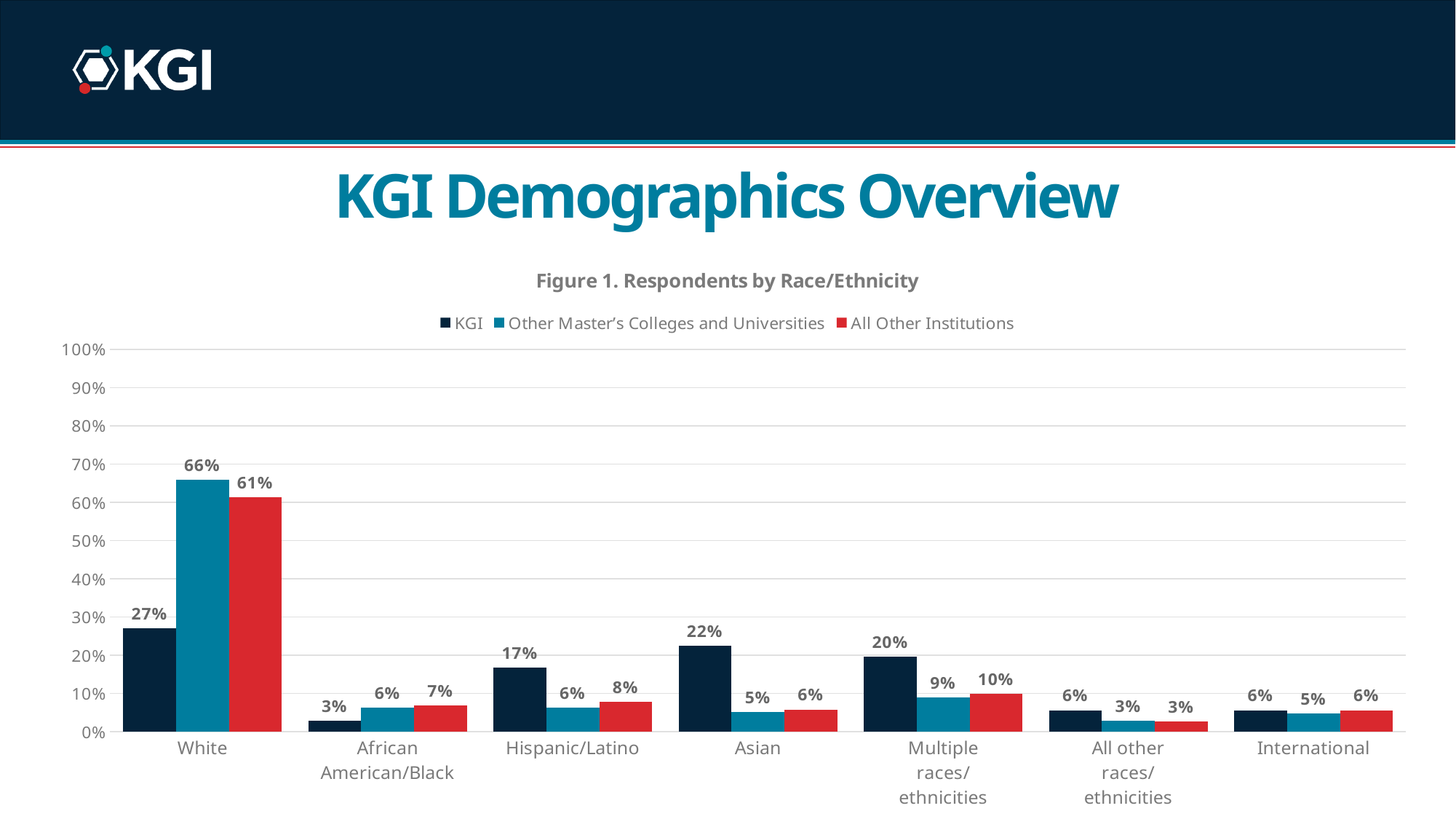
What kind of chart is shown on the slide? Bar chart What is the All Other Institutions value for Multiple races/ethnicities? 10% What is the value for Other Master's Colleges and Universities in the Asian category? 5% Is the All Other Institutions value for White respondents greater or less than 50%? greater How many race/ethnicity categories are shown on the x axis? 7 Which category has the highest KGI value? White What is the title of the figure? Figure 1. Respondents by Race/Ethnicity How many series does the legend list? 3 What is the KGI value for White respondents? 27% Which category has the lowest KGI value? African American/Black What is the difference between the Other Master's Colleges and Universities value and the KGI value for White respondents? 39% For Hispanic/Latino, which is larger: the KGI value or the All Other Institutions value? KGI